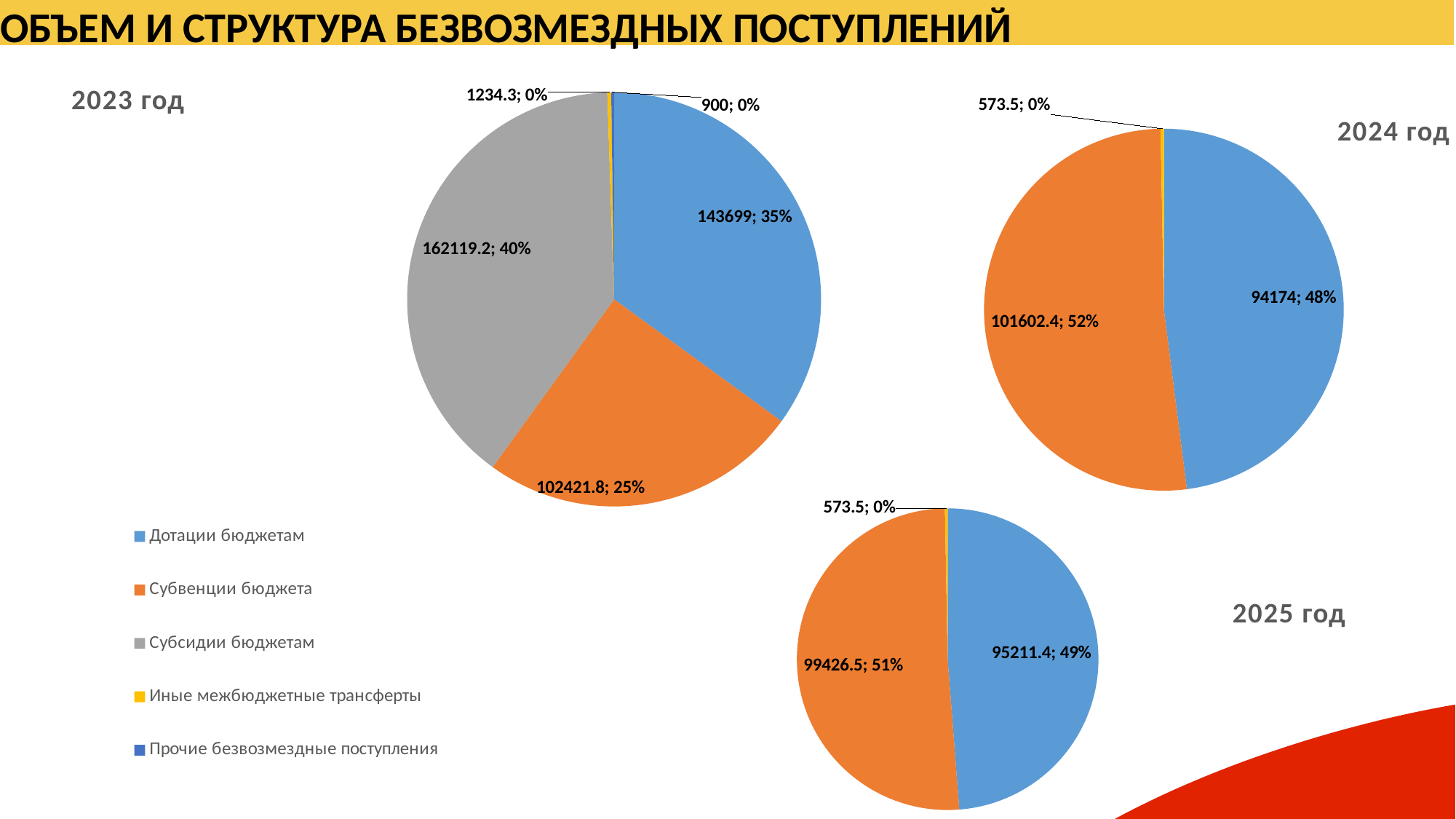
Which colour represents Иные межбюджетные трансферты in the legend? Yellow In the 2023 год chart, which category has the largest slice? Субсидии бюджетам How many categories does the legend list? 5 In the 2023 год chart, what share of the pie does Дотации бюджетам take? 35% What type of charts are shown on the slide? Pie charts In the 2024 год chart, which is larger: Дотации бюджетам or Субвенции бюджета? Субвенции бюджета In the 2023 год chart, what is the difference between the values for Субсидии бюджетам and Субвенции бюджета? 59697.4 In the 2025 год chart, what is the value for Дотации бюджетам? 95211.4 In the 2024 год chart, what is the value for Субвенции бюджета? 101602.4 In the 2024 год chart, what share of the pie does Дотации бюджетам take? 48% In the 2023 год chart, what is the value for Субсидии бюджетам? 162119.2 In the 2025 год chart, what is the difference between the values for Субвенции бюджета and Дотации бюджетам? 4215.1